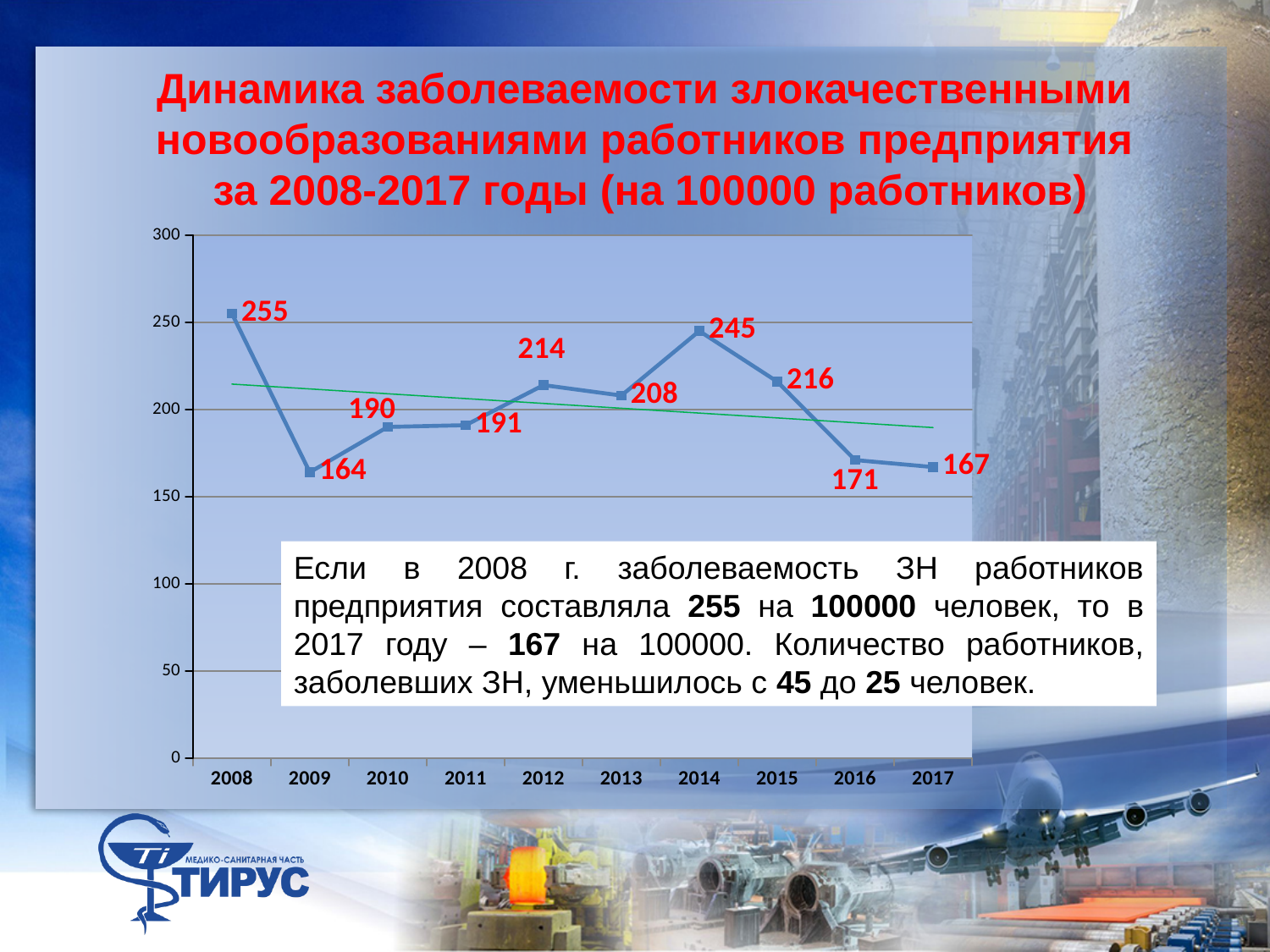
Which is larger, the value for 2012 or the value for 2013? 2012 What is the value for 2008? 255 What is the difference between the values for 2008 and 2017? 88 Does the green trend line rise or fall from 2008 to 2017? fall Is the value for 2016 greater or less than 200? less What is the difference between the values for 2014 and 2015? 29 Which year has the highest value? 2008 What is the value for 2014? 245 What is the value for 2017? 167 Which year has the lowest value? 2009 What type of chart is shown on the slide? line chart How many years are plotted on the x axis? 10